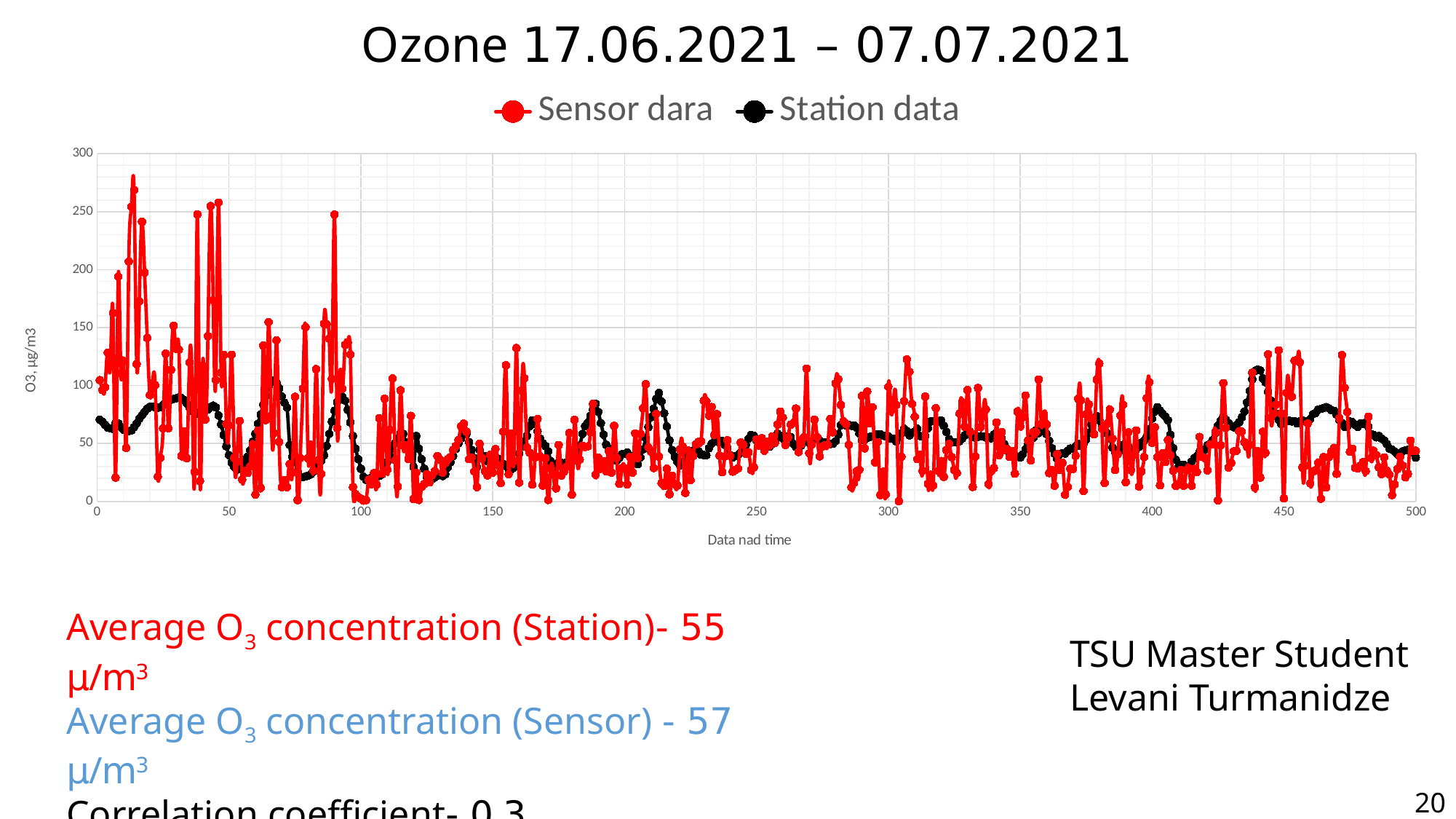
What kind of chart is shown on the slide? line chart What are the two series named in the legend? Sensor dara and Station data Is the Sensor dara value at x = 300 greater or less than 150? less Is the highest value of the Station data series greater or less than 200? less Is the Station data value at x = 100 greater or less than 50? less Are the Sensor dara values generally higher near the start of the x axis or near the end? near the start How many series does the legend list? 2 Which series reaches the higher maximum value, Sensor dara or Station data? Sensor dara What is the title of the chart? Ozone 17.06.2021 – 07.07.2021